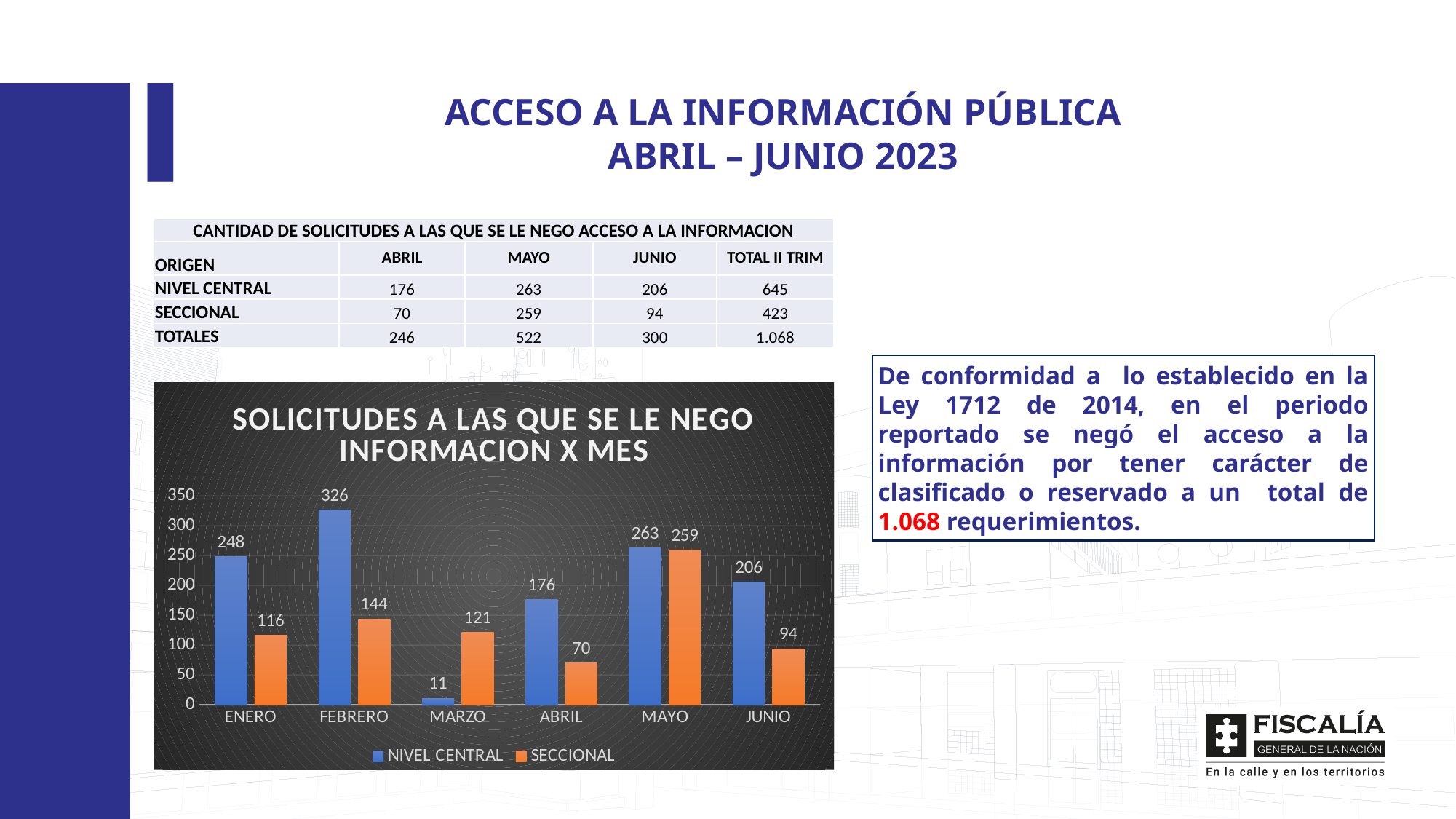
What kind of chart is shown on the slide? Bar chart In MARZO, which series has the larger value, NIVEL CENTRAL or SECCIONAL? SECCIONAL What is the SECCIONAL value for MARZO in the chart? 121 What is the SECCIONAL value for MAYO in the chart? 259 How many series does the chart legend list? 2 Which month has the lowest NIVEL CENTRAL value in the chart? MARZO Which month has the highest NIVEL CENTRAL value in the chart? FEBRERO What is the NIVEL CENTRAL value for FEBRERO in the chart? 326 What is the title of the chart on the slide? SOLICITUDES A LAS QUE SE LE NEGO INFORMACION X MES Which month has the lowest SECCIONAL value in the chart? ABRIL How many months are shown on the x axis of the chart? 6 What is the difference between the NIVEL CENTRAL and SECCIONAL values for ENERO? 132